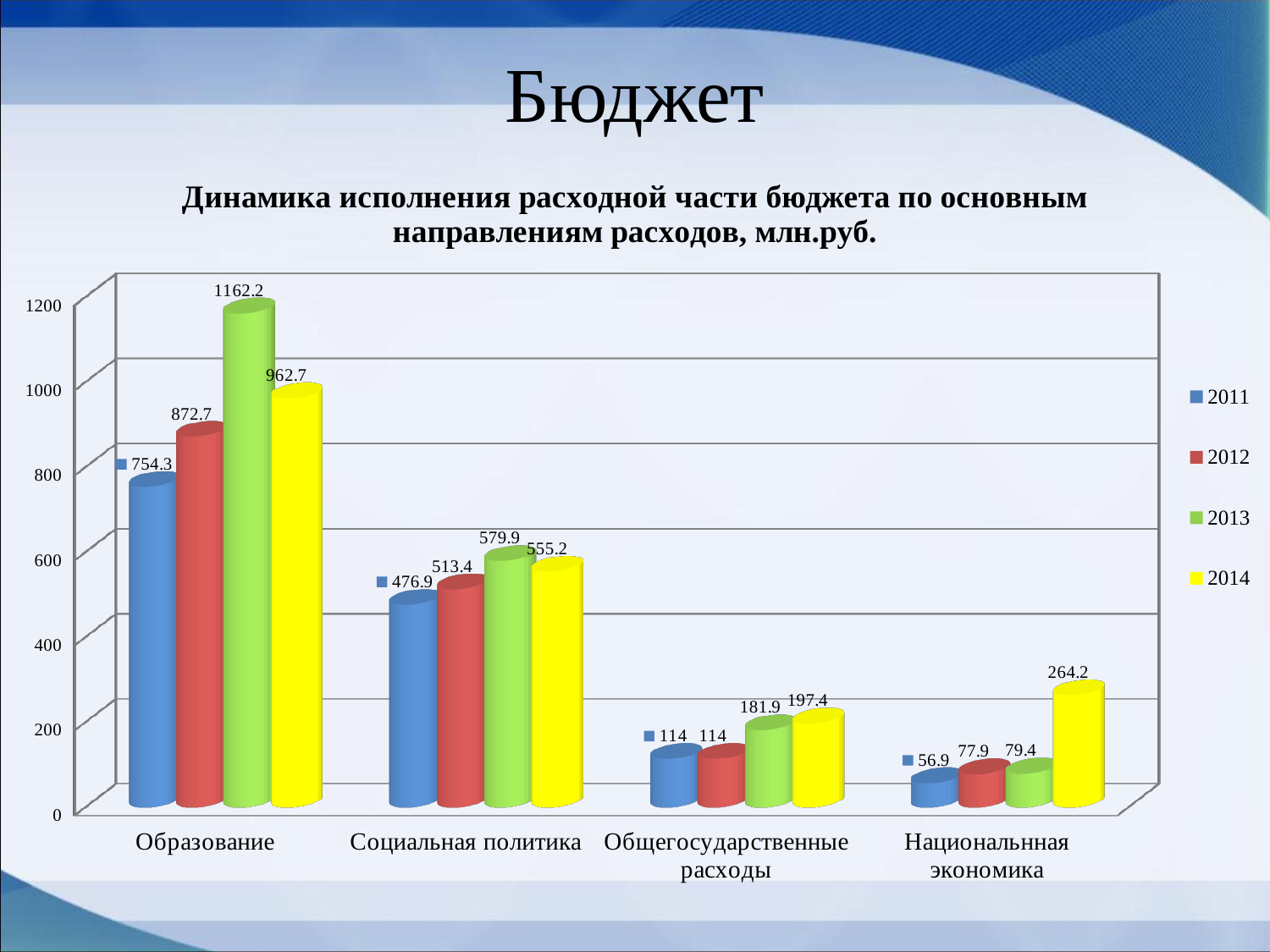
How many series does the legend list? 4 Which category has the highest value in 2012? Образование Which is larger for Общегосударственные расходы: the 2013 value or the 2014 value? 2014 What is the value for Образование in 2013? 1162.2 What is the value for Национальная экономика in 2014? 264.2 What kind of chart is shown on the slide? bar chart What is the difference between the 2013 and 2014 values for Образование? 199.5 Which category has the lowest value in 2011? Национальная экономика How many categories are shown on the x axis? 4 What is the value for Социальная политика in 2011? 476.9 What colour represents the 2014 series in the legend? yellow Do the values for Национальная экономика rise or fall from 2011 to 2014? rise